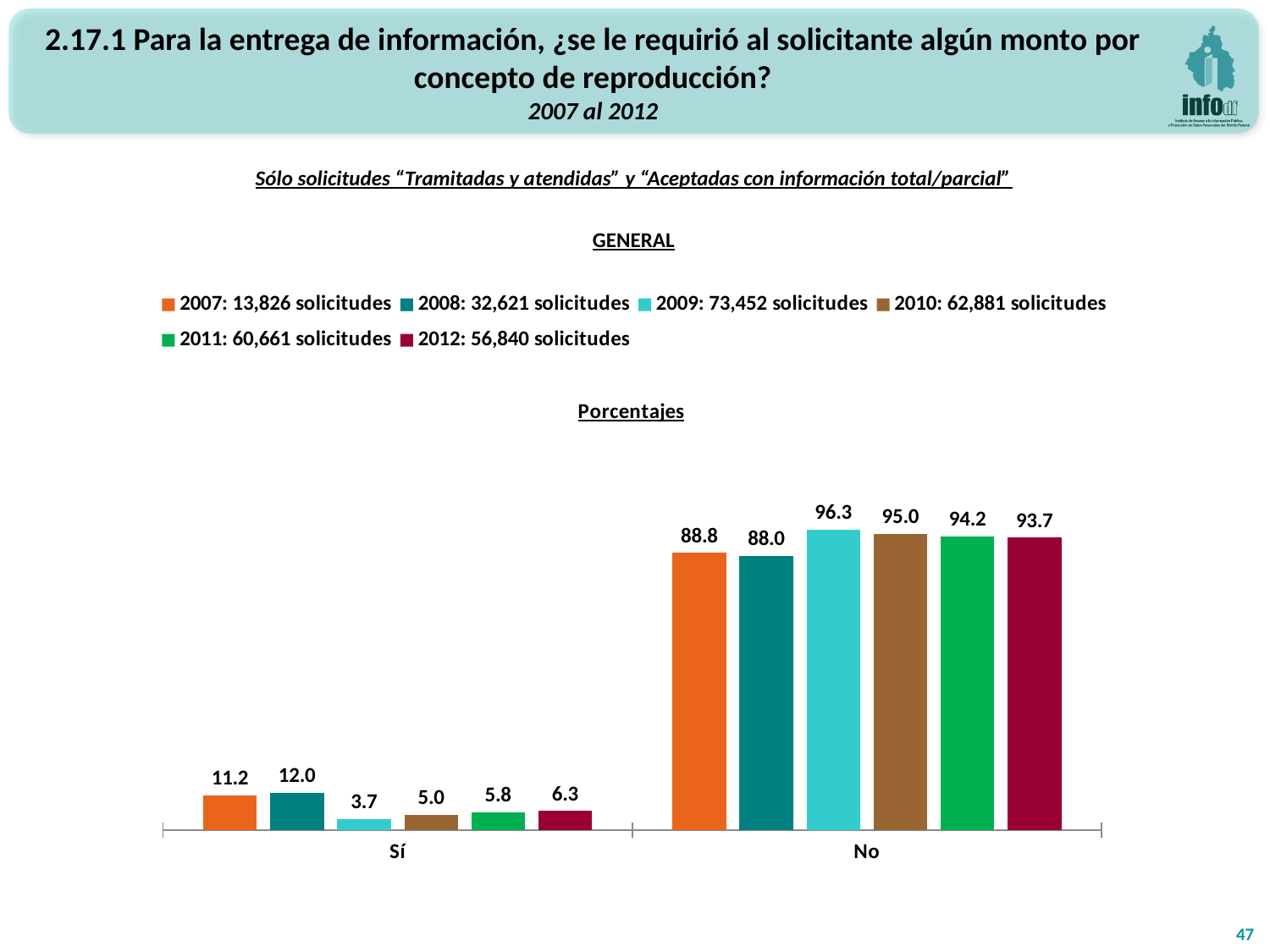
According to the legend, how many solicitudes were there in 2009? 73,452 solicitudes What is the total of the 2012 values for "Sí" and "No"? 100.0 How many categories are shown on the x axis? 2 How many series does the legend list? 6 What is the value for 2009 in the "No" category? 96.3 Which year has the highest value in the "No" category? 2009 Which year has the lowest value in the "Sí" category? 2009 What kind of chart is shown on the slide? Bar chart Which is larger in the "No" category: the value for 2010 or the value for 2011? 2010 What is the value for 2007 in the "Sí" category? 11.2 What is the value for 2012 in the "Sí" category? 6.3 What is the difference between the 2008 and 2007 values in the "Sí" category? 0.8